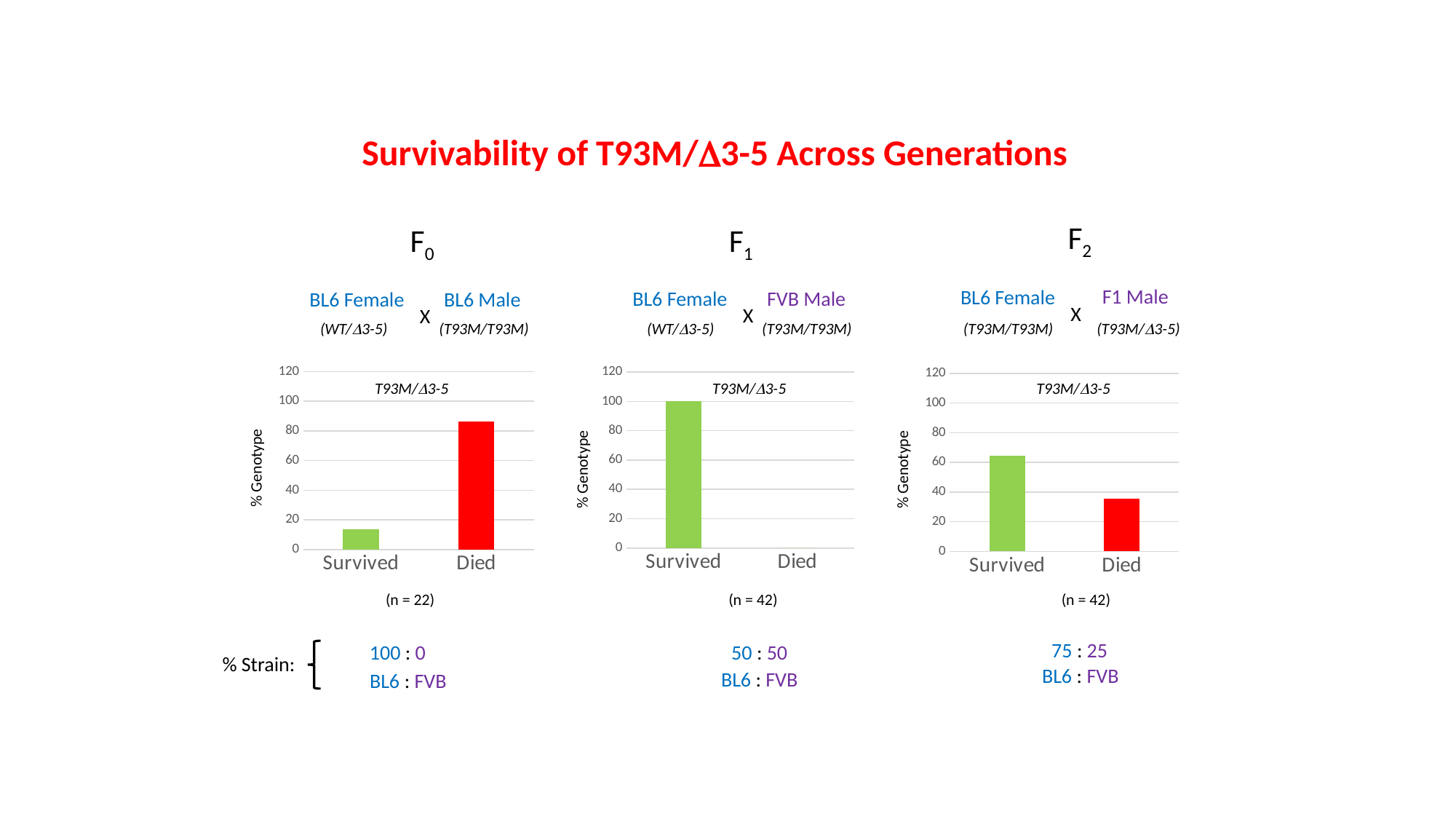
In the F0 chart, which category is highest? Died In the F2 chart, is the value for Survived greater or less than 60? greater What is the y-axis label of the F2 chart? % Genotype In the F1 chart, what is the value for Died? 0 What kind of chart is the F0 chart? bar chart In the F0 chart, is the value for Survived greater or less than 20? less In the F2 chart, which category is lowest? Died How many categories are shown on the x axis of the F1 chart? 2 In the F0 chart, is the value for Died greater or less than 80? greater In the F2 chart, which is larger, Survived or Died? Survived In the F1 chart, what is the value for Survived? 100